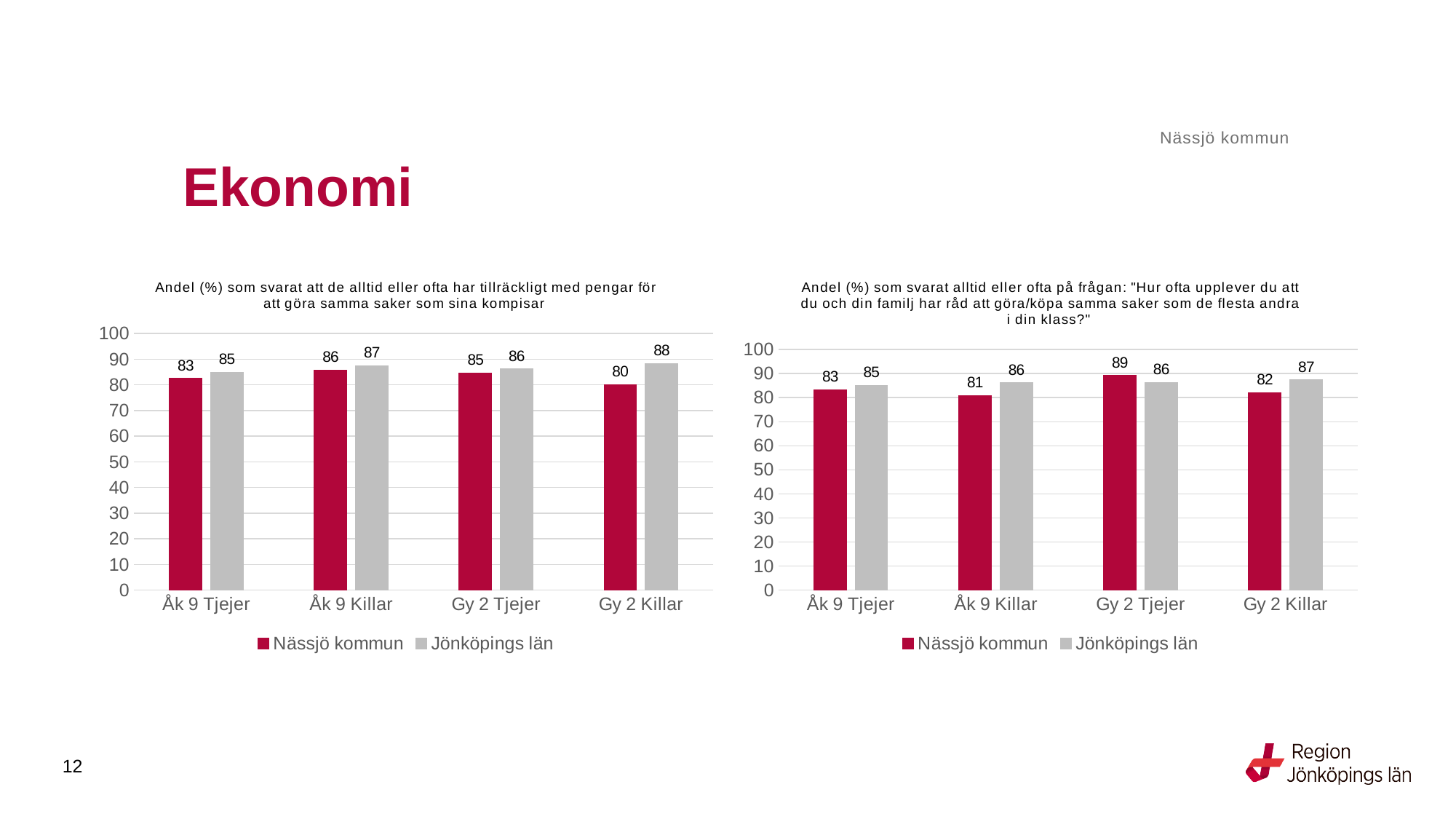
In the right chart, which category has the highest value for Nässjö kommun? Gy 2 Tjejer In the left chart, what is the value for Nässjö kommun for Åk 9 Tjejer? 83 In the right chart, what is the difference between Jönköpings län and Nässjö kommun for Åk 9 Killar? 5 In the right chart, which is larger for Gy 2 Tjejer: Nässjö kommun or Jönköpings län? Nässjö kommun What kind of chart is the left chart? Bar chart In the right chart, what is the value for Jönköpings län for Åk 9 Killar? 86 How many series does the legend of the right chart list? 2 In the left chart, which category has the lowest value for Nässjö kommun? Gy 2 Killar In the right chart, what is the value for Nässjö kommun for Gy 2 Tjejer? 89 In the left chart, what is the difference between Jönköpings län and Nässjö kommun for Gy 2 Killar? 8 How many categories are shown on the x axis of the left chart? 4 In the left chart, what is the value for Jönköpings län for Gy 2 Killar? 88